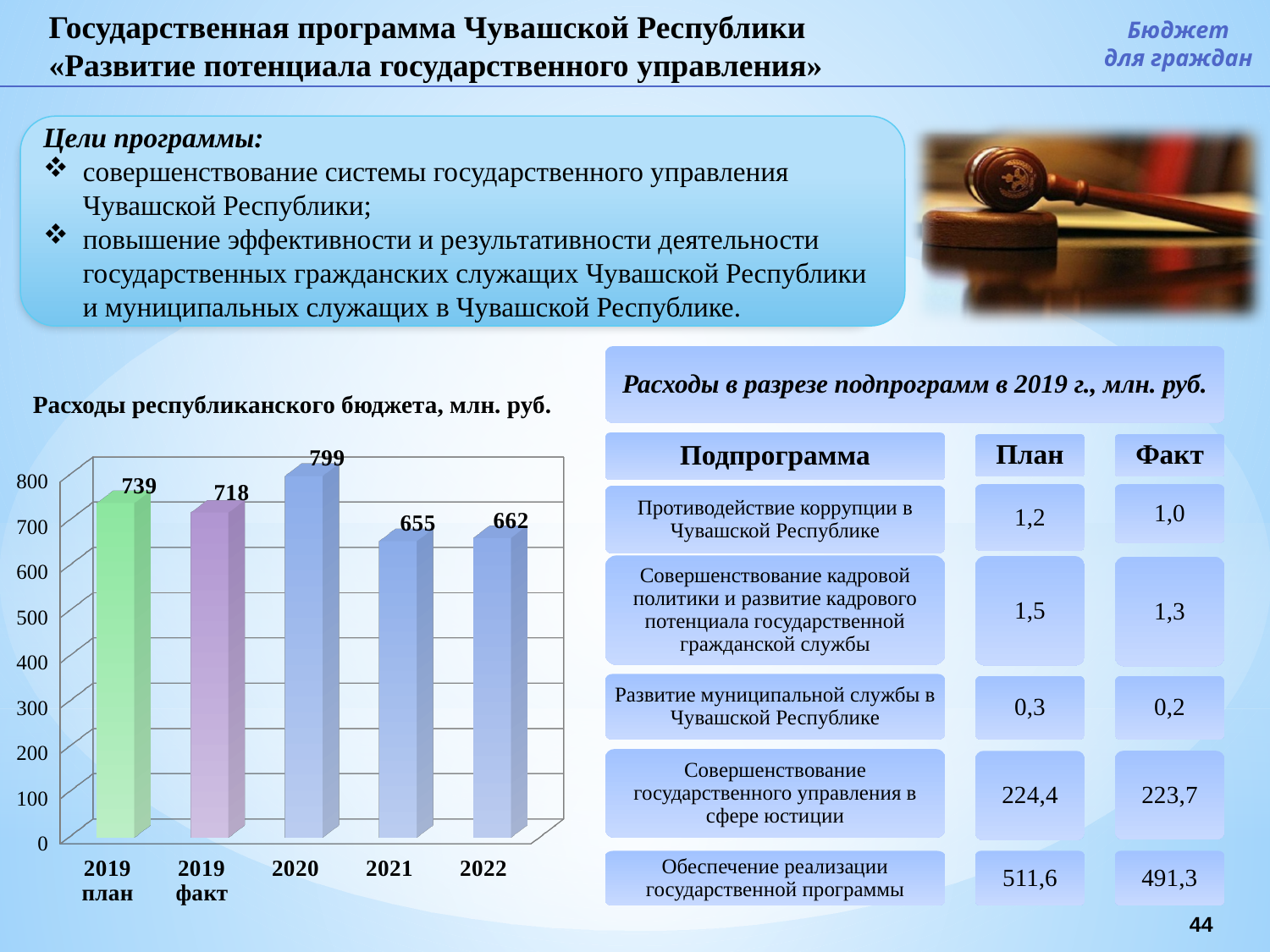
What is the title of the chart on the left side of the slide? Расходы республиканского бюджета, млн. руб. In the chart 'Расходы республиканского бюджета, млн. руб.', which is larger: the value for 2020 or the value for 2022? 2020 What is the difference between the 2019 план and 2019 факт values in the chart 'Расходы республиканского бюджета, млн. руб.'? 21 What is the value for 2020 in the chart 'Расходы республиканского бюджета, млн. руб.'? 799 What type of chart is 'Расходы республиканского бюджета, млн. руб.'? Bar chart Which category has the highest value in the chart 'Расходы республиканского бюджета, млн. руб.'? 2020 Which category has the lowest value in the chart 'Расходы республиканского бюджета, млн. руб.'? 2021 What is the value for 2022 in the chart 'Расходы республиканского бюджета, млн. руб.'? 662 What is the value for 2019 факт in the chart 'Расходы республиканского бюджета, млн. руб.'? 718 How many bars are shown in the chart 'Расходы республиканского бюджета, млн. руб.'? 5 What is the difference between the 2020 and 2021 values in the chart 'Расходы республиканского бюджета, млн. руб.'? 144 What is the value for 2019 план in the chart 'Расходы республиканского бюджета, млн. руб.'? 739